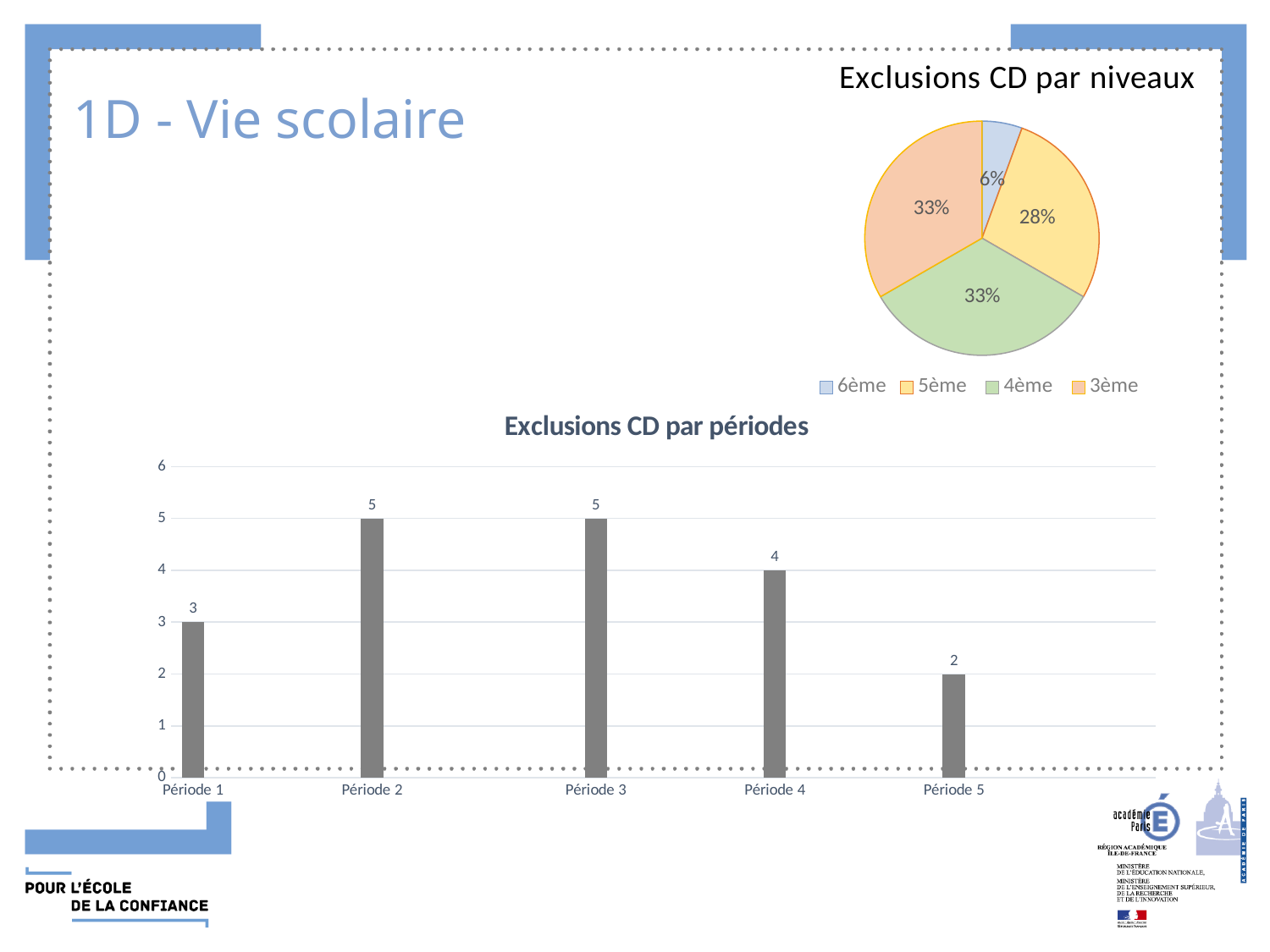
In the 'Exclusions CD par périodes' chart, which period has the lowest value? Période 5 In the 'Exclusions CD par périodes' chart, do the values rise or fall from Période 3 to Période 5? Fall In the 'Exclusions CD par périodes' chart, what is the value for Période 2? 5 In the 'Exclusions CD par niveaux' pie chart, which level has the smallest share? 6ème In the 'Exclusions CD par niveaux' pie chart, what share does 5ème have? 28% How many periods are shown in the 'Exclusions CD par périodes' chart? 5 In the 'Exclusions CD par périodes' chart, what is the value for Période 5? 2 In the 'Exclusions CD par périodes' chart, what is the difference between the values for Période 3 and Période 1? 2 What kind of chart is 'Exclusions CD par périodes'? Bar chart What kind of chart is 'Exclusions CD par niveaux'? Pie chart How many entries does the legend of the 'Exclusions CD par niveaux' pie chart list? 4 In the 'Exclusions CD par périodes' chart, which is larger, the value for Période 4 or the value for Période 5? Période 4